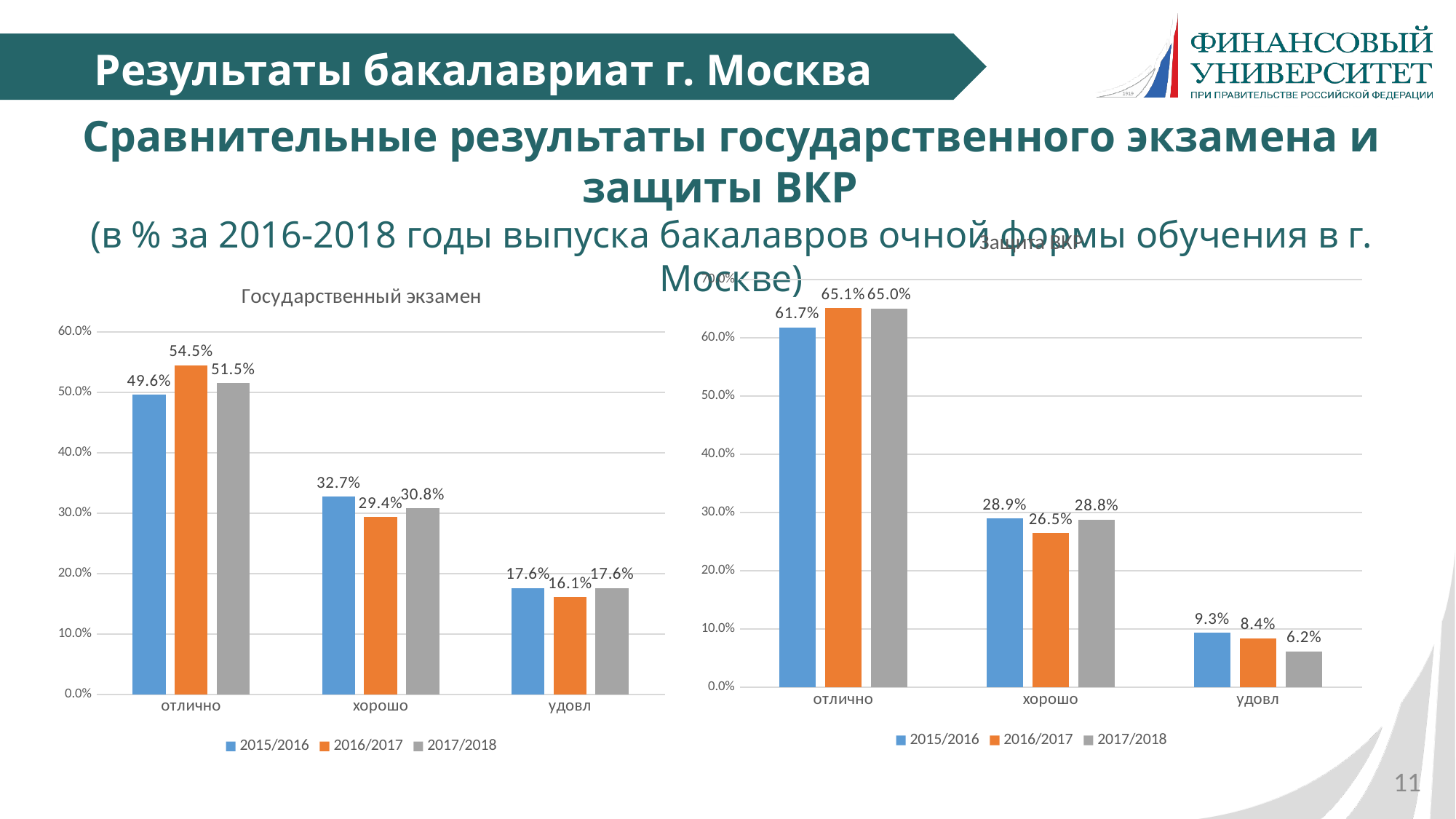
In the right-hand chart (Защита ВКР), how many categories are shown on the x axis? 3 In the right-hand chart (Защита ВКР), what is the difference between the 2015/2016 and 2016/2017 values in the "удовл" category? 0.9% In the right-hand chart (Защита ВКР), which is larger in the "хорошо" category: 2015/2016 or 2016/2017? 2015/2016 In the chart titled "Государственный экзамен", what is the value for 2016/2017 in the "отлично" category? 54.5% In the chart titled "Государственный экзамен", what is the value for 2015/2016 in the "хорошо" category? 32.7% In the chart titled "Государственный экзамен", what is the difference between the 2016/2017 and 2015/2016 values in the "отлично" category? 4.9% In the chart titled "Государственный экзамен", which series has the highest value in the "отлично" category? 2016/2017 In the right-hand chart (Защита ВКР), what is the value for 2015/2016 in the "отлично" category? 61.7% In the right-hand chart (Защита ВКР), which series has the lowest value in the "удовл" category? 2017/2018 In the right-hand chart (Защита ВКР), what is the value for 2017/2018 in the "удовл" category? 6.2% In the chart titled "Государственный экзамен", what kind of chart is shown? Bar chart In the chart titled "Государственный экзамен", how many series does the legend list? 3